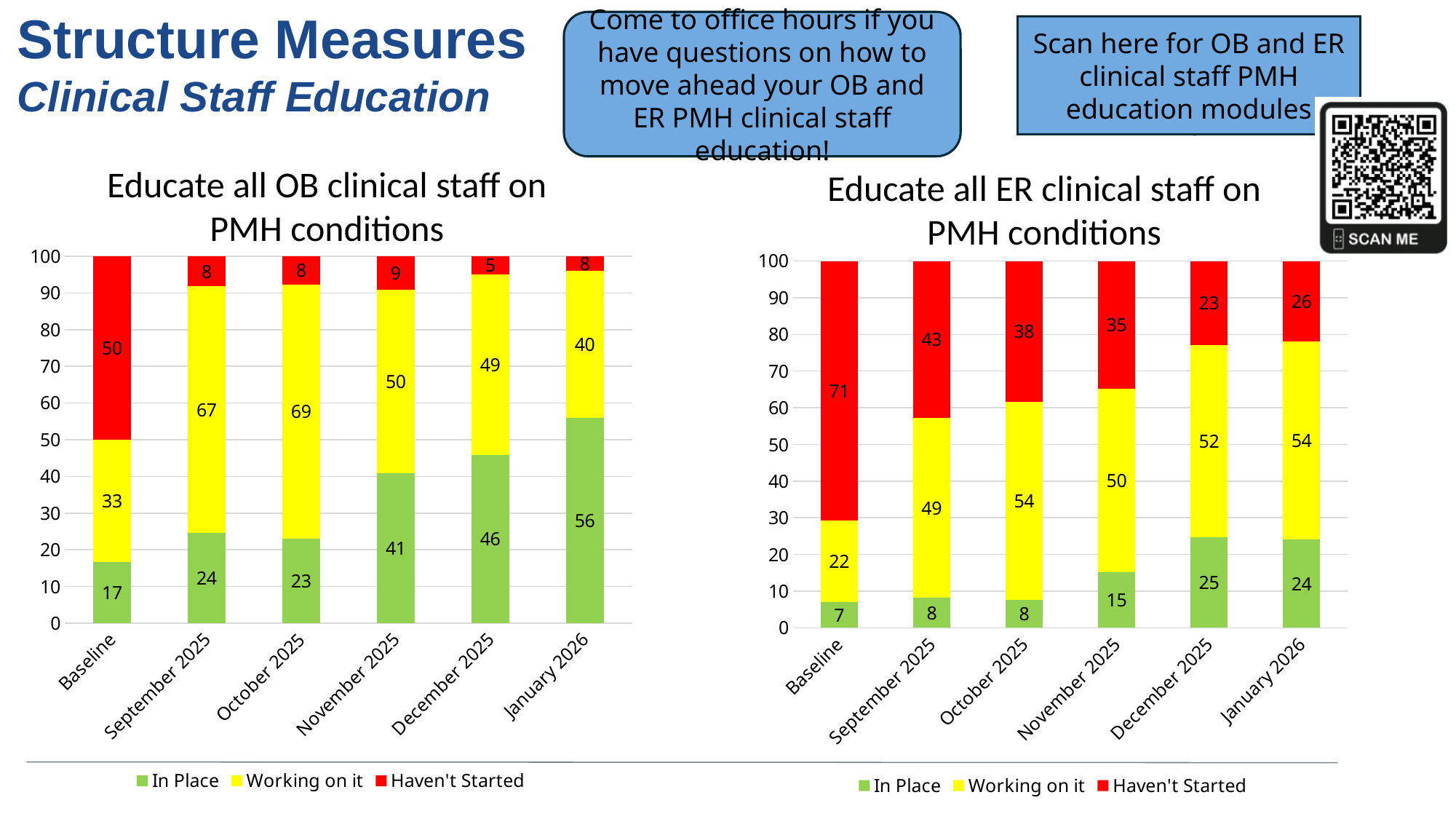
In the 'Educate all ER clinical staff on PMH conditions' chart, which is larger: the Working on it value for October 2025 or for November 2025? October 2025 How many series does the legend of the 'Educate all OB clinical staff on PMH conditions' chart list? 3 In the 'Educate all ER clinical staff on PMH conditions' chart, what is the Haven't Started value at Baseline? 71 How many categories are shown on the x axis of the 'Educate all ER clinical staff on PMH conditions' chart? 6 In the 'Educate all OB clinical staff on PMH conditions' chart, what is the In Place value for January 2026? 56 In the 'Educate all ER clinical staff on PMH conditions' chart, which category has the lowest Haven't Started value? December 2025 What kind of chart is the 'Educate all ER clinical staff on PMH conditions' chart? Stacked bar chart In the 'Educate all ER clinical staff on PMH conditions' chart, what colour represents the Haven't Started series? Red In the 'Educate all ER clinical staff on PMH conditions' chart, what is the In Place value for November 2025? 15 In the 'Educate all OB clinical staff on PMH conditions' chart, what is the Working on it value for October 2025? 69 In the 'Educate all OB clinical staff on PMH conditions' chart, which category has the highest In Place value? January 2026 In the 'Educate all OB clinical staff on PMH conditions' chart, what is the difference between the In Place values for January 2026 and Baseline? 39